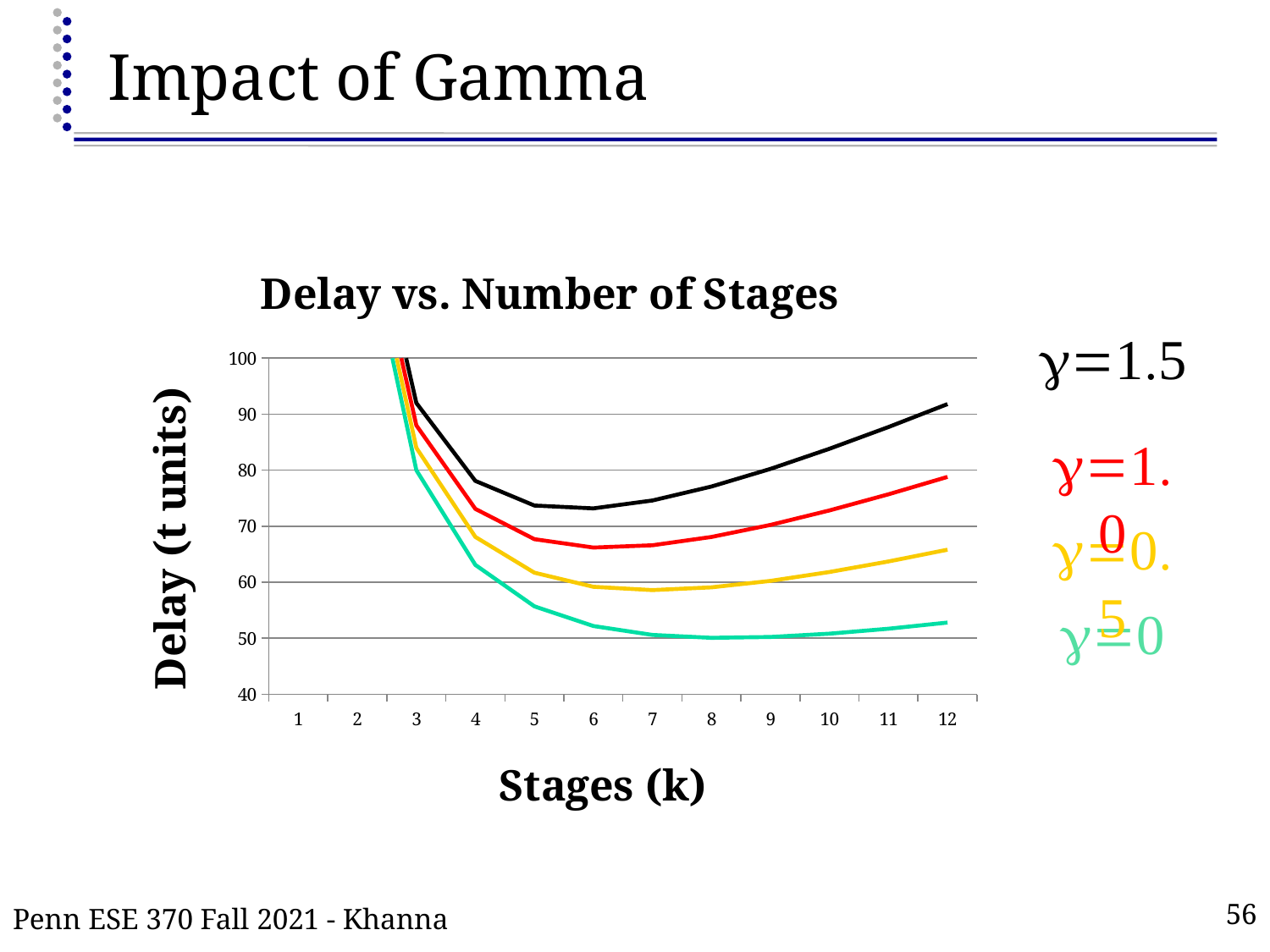
Which line has the highest delay at stage 12? the black line (γ=1.5) What is the title of the chart? Delay vs. Number of Stages What kind of chart is shown on the slide? line chart Is the delay of the red line (γ=1.0) at stage 6 greater or less than 70? less Does the delay of the black line (γ=1.5) rise or fall from stage 6 to stage 12? rise Which line has the lowest delay at stage 12? the green line (γ=0) How many lines are plotted on the chart? 4 At stage 6, which is larger: the delay of the black line (γ=1.5) or the green line (γ=0)? the black line (γ=1.5) How many stage values are marked along the x axis of the chart? 12 Is the delay of the black line (γ=1.5) at stage 6 greater or less than 70? greater Is the delay of the yellow line (γ=0.5) at stage 12 greater or less than 60? greater What is the label of the x axis of the chart? Stages (k)